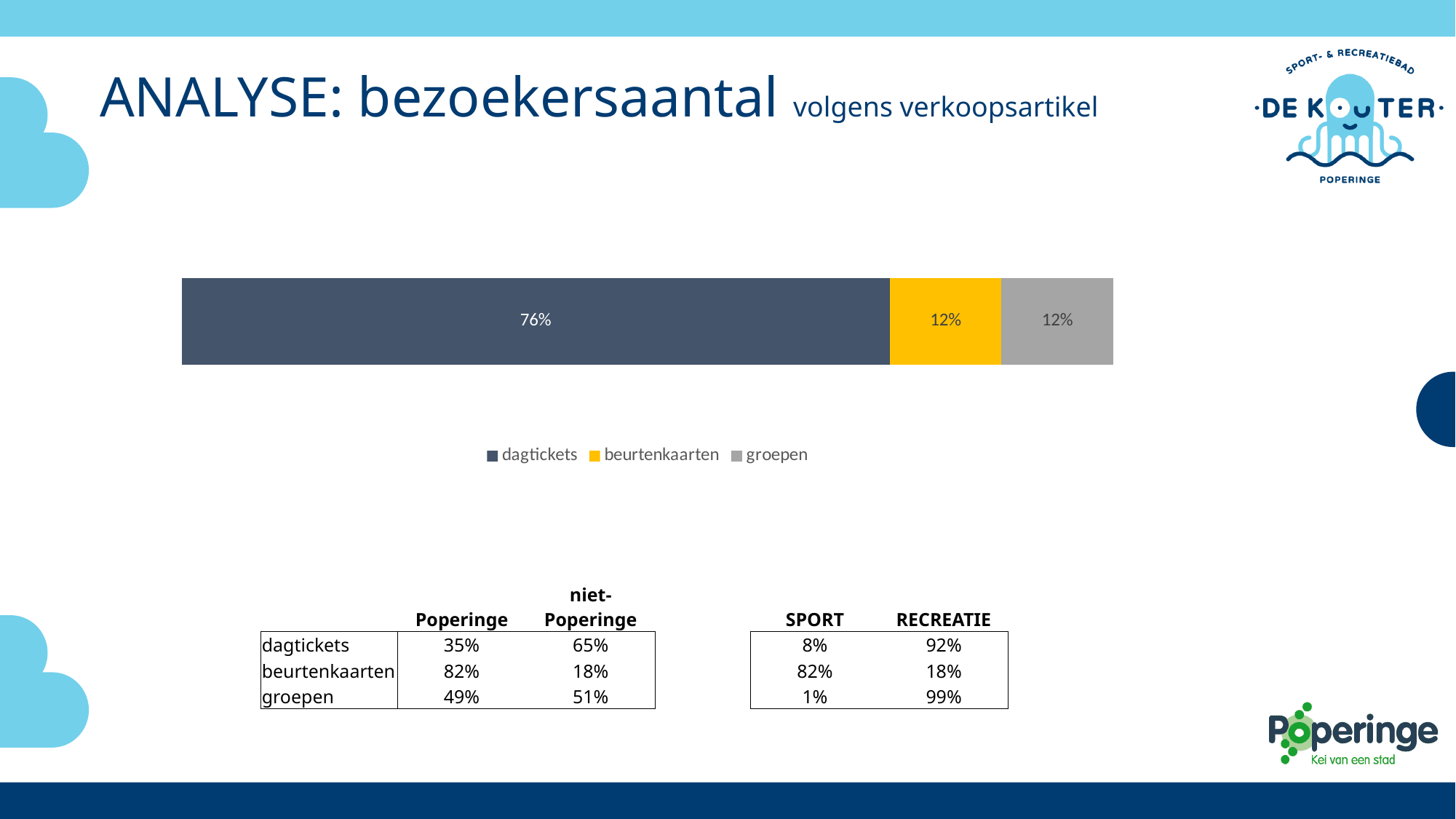
Which series has the largest share of the stacked bar? dagtickets What percentage does the groepen segment of the stacked bar show? 12% What is the difference between the dagtickets share and the beurtenkaarten share? 64% What percentage does the dagtickets segment of the stacked bar show? 76% What is the total of the three segments in the stacked bar? 100% Is the dagtickets share greater or less than 50%? greater Which is larger, the dagtickets segment or the groepen segment? dagtickets How many series does the legend list? 3 Which series is shown in grey in the stacked bar? groepen What kind of chart is shown on the slide? stacked bar chart What percentage does the beurtenkaarten segment of the stacked bar show? 12% Which colour represents beurtenkaarten in the legend? yellow